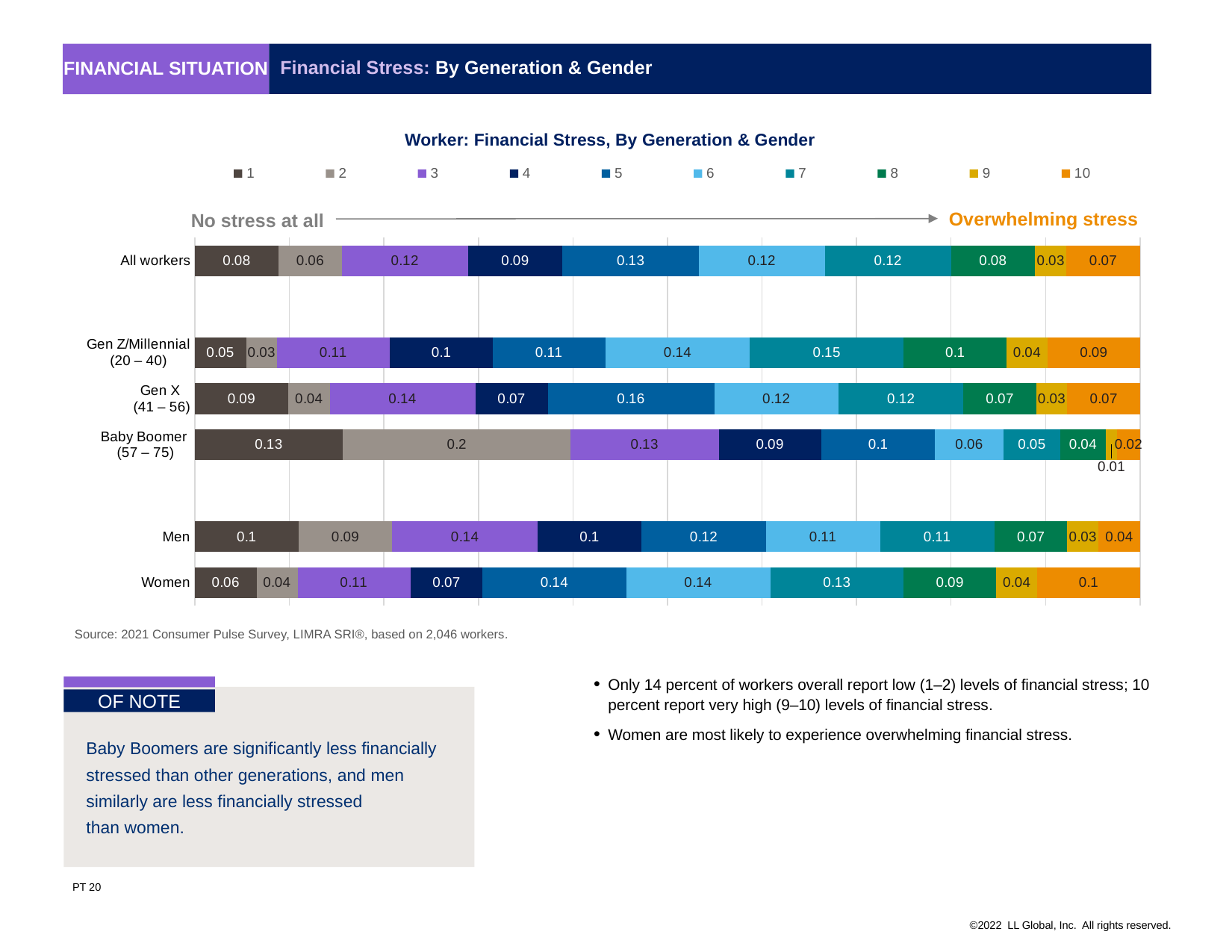
How many categories (bars) are plotted in the chart? 6 What is the title of the chart? Worker: Financial Stress, By Generation & Gender What is the value for series 7 in the Gen Z/Millennial (20 – 40) bar? 0.15 How many series does the legend list? 10 What is the difference between the series 2 value for Baby Boomer (57 – 75) and the series 2 value for Gen Z/Millennial (20 – 40)? 0.17 What is the value for series 5 in the Gen X (41 – 56) bar? 0.16 What is the value for series 10 in the Women bar? 0.1 Which is larger: the series 10 value for Men or the series 10 value for Women? Women Which category has the highest value for series 10? Women Which category has the lowest value for series 1? Gen Z/Millennial (20 – 40) What kind of chart is shown on the slide? Stacked bar chart What is the value for series 2 in the Baby Boomer (57 – 75) bar? 0.2